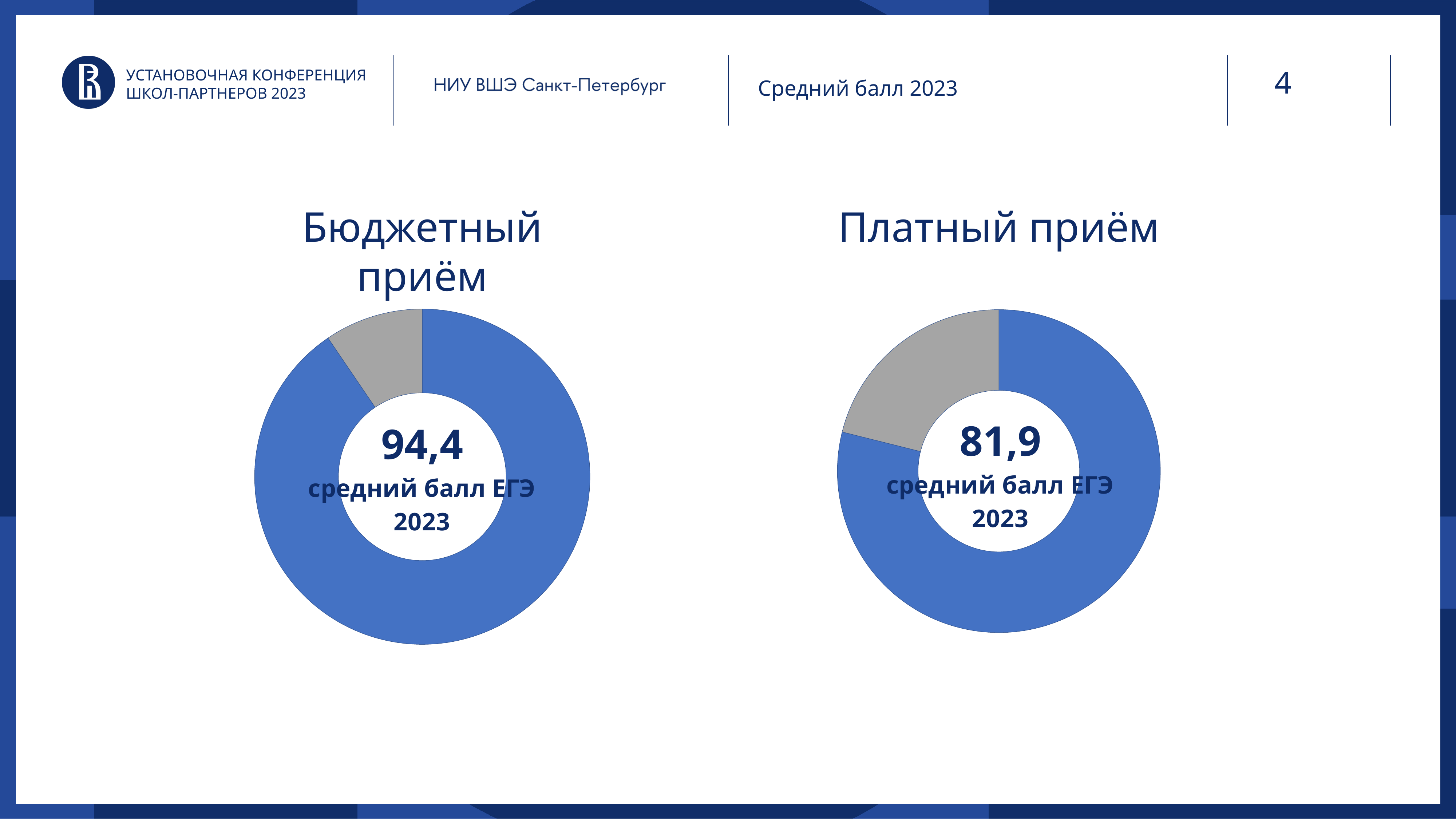
How many slices does the "Платный приём" donut chart have? 2 What kind of chart is used for "Бюджетный приём"? Donut chart In the "Платный приём" chart, which slice is larger, the blue one or the grey one? Blue What is the difference between the average ЕГЭ scores shown in the "Бюджетный приём" and "Платный приём" charts? 12,5 What kind of chart is used for "Платный приём"? Donut chart In the "Бюджетный приём" chart, which slice is larger, the blue one or the grey one? Blue What is the title of the chart on the right side of the slide? Платный приём Which chart shows the higher average ЕГЭ score, "Бюджетный приём" or "Платный приём"? Бюджетный приём What average ЕГЭ score for 2023 is shown in the centre of the "Бюджетный приём" chart? 94,4 How many slices does the "Бюджетный приём" donut chart have? 2 What average ЕГЭ score for 2023 is shown in the centre of the "Платный приём" chart? 81,9